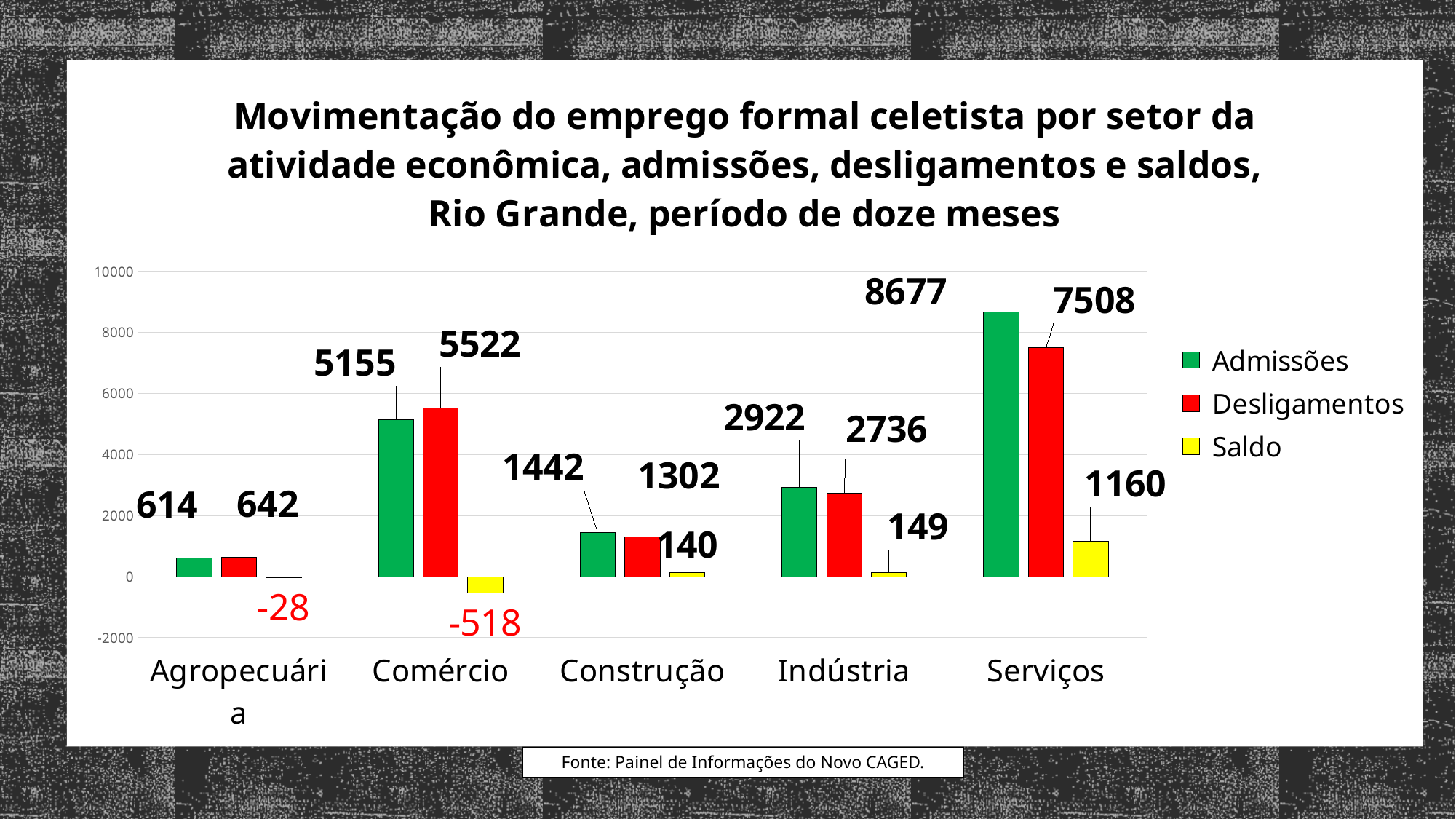
What is the Saldo value for Indústria? 149 Which is larger for Agropecuária, Admissões or Desligamentos? Desligamentos What is the Desligamentos value for Comércio? 5522 How many sectors are shown on the x axis? 5 How many series does the legend list? 3 What kind of chart is shown on the slide? Bar chart Which sector has the highest Admissões value? Serviços What is the difference between Admissões and Desligamentos for Indústria? 186 What is the Admissões value for Serviços? 8677 What colour are the Saldo bars? Yellow Which sector has the lowest Saldo value? Comércio What is the Saldo value for Comércio? -518